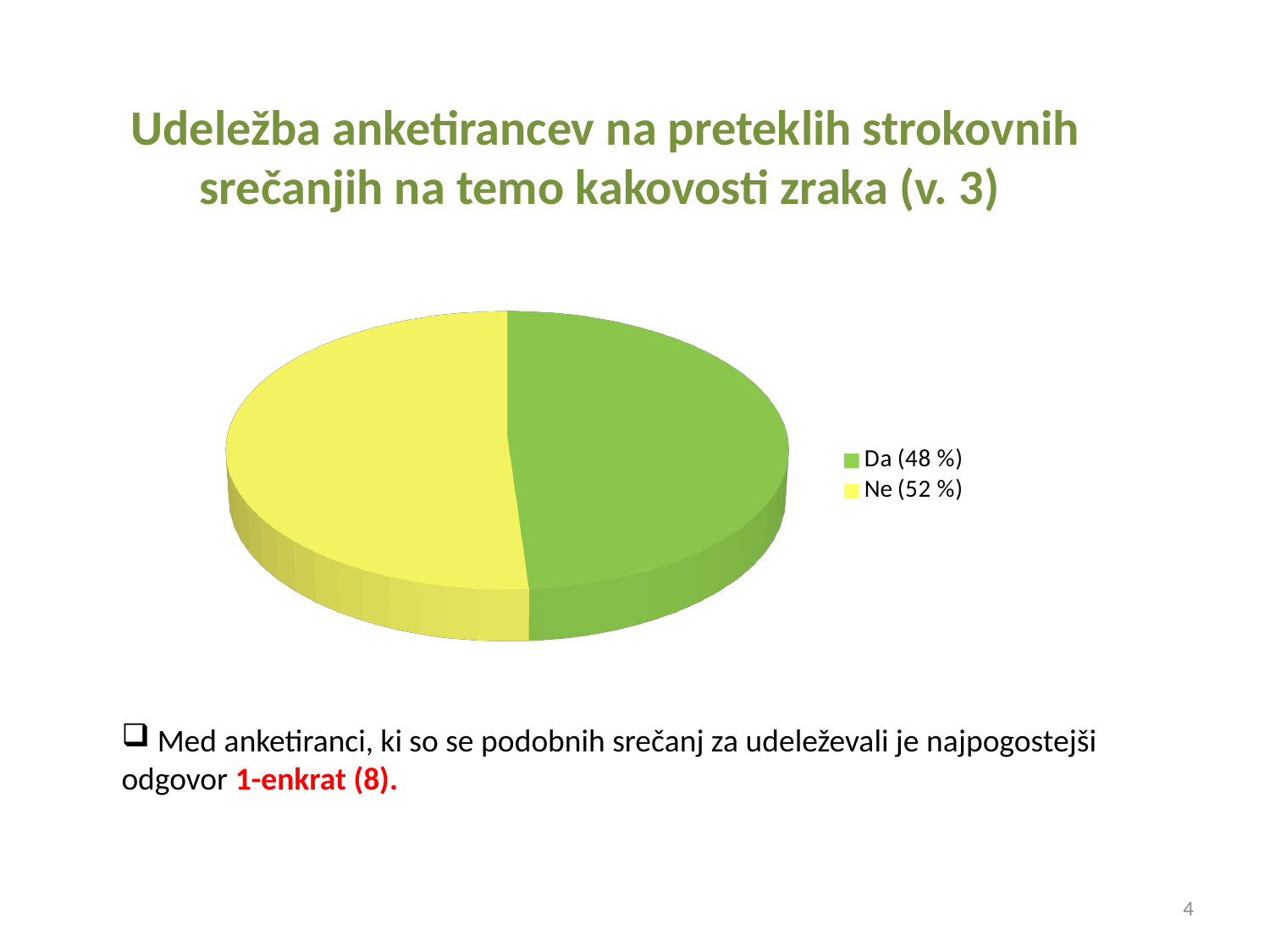
Is the share for "Da" greater or less than 50 %? less Which slice is the largest in the pie chart? Ne (52 %) What is the difference in percentage points between the "Ne" and "Da" slices? 4 What share of the pie does the "Ne" slice represent? 52 % What kind of chart is shown on the slide? pie chart What is the title of the chart on the slide? Udeležba anketirancev na preteklih strokovnih srečanjih na temo kakovosti zraka (v. 3) What share of the pie does the "Da" slice represent? 48 % How many entries does the legend list? 2 How many slices does the pie chart have? 2 Which is larger, the "Da" slice or the "Ne" slice? Ne Which slice is the smallest in the pie chart? Da (48 %) What colour is the "Ne (52 %)" slice? yellow